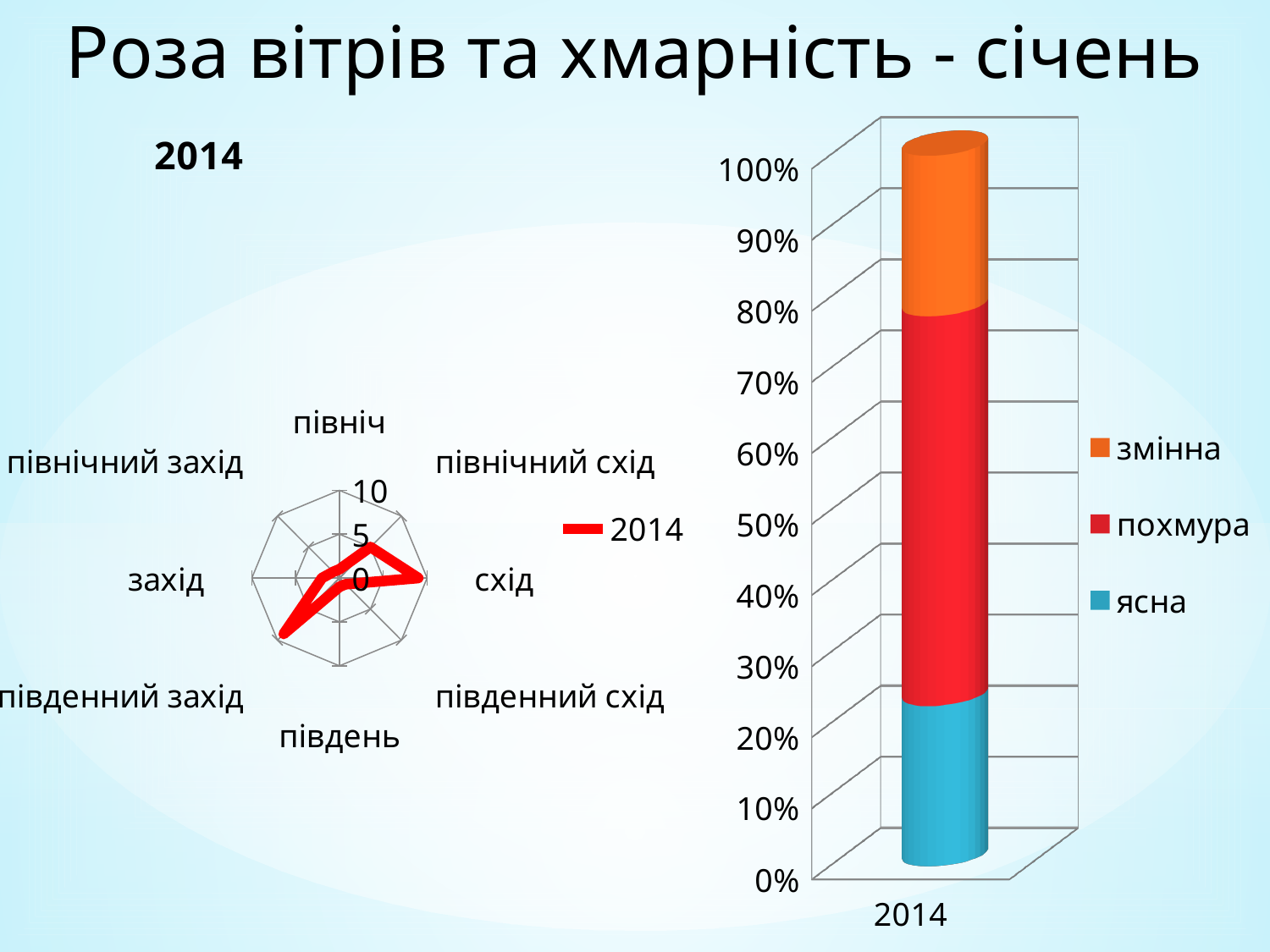
In the left-hand radar chart, which has the larger value: схід or північ? схід In the left-hand radar chart, is the value for південь greater or less than 5? less In the right-hand stacked bar chart, which series occupies the largest share of the 2014 bar? похмура In the left-hand radar chart, is the value for схід greater or less than 5? greater How many direction categories does the left-hand radar chart have? 8 How many series does the legend of the right-hand chart list? 3 In the right-hand chart, is the share of ясна greater or less than 30%? less What kind of chart is the chart on the right side of the slide? bar chart What are the legend entries of the right-hand chart? змінна, похмура, ясна What kind of chart is the chart on the left side of the slide (titled 2014)? radar chart How many categories are shown on the x axis of the right-hand chart? 1 How many series does the legend of the left-hand radar chart list? 1